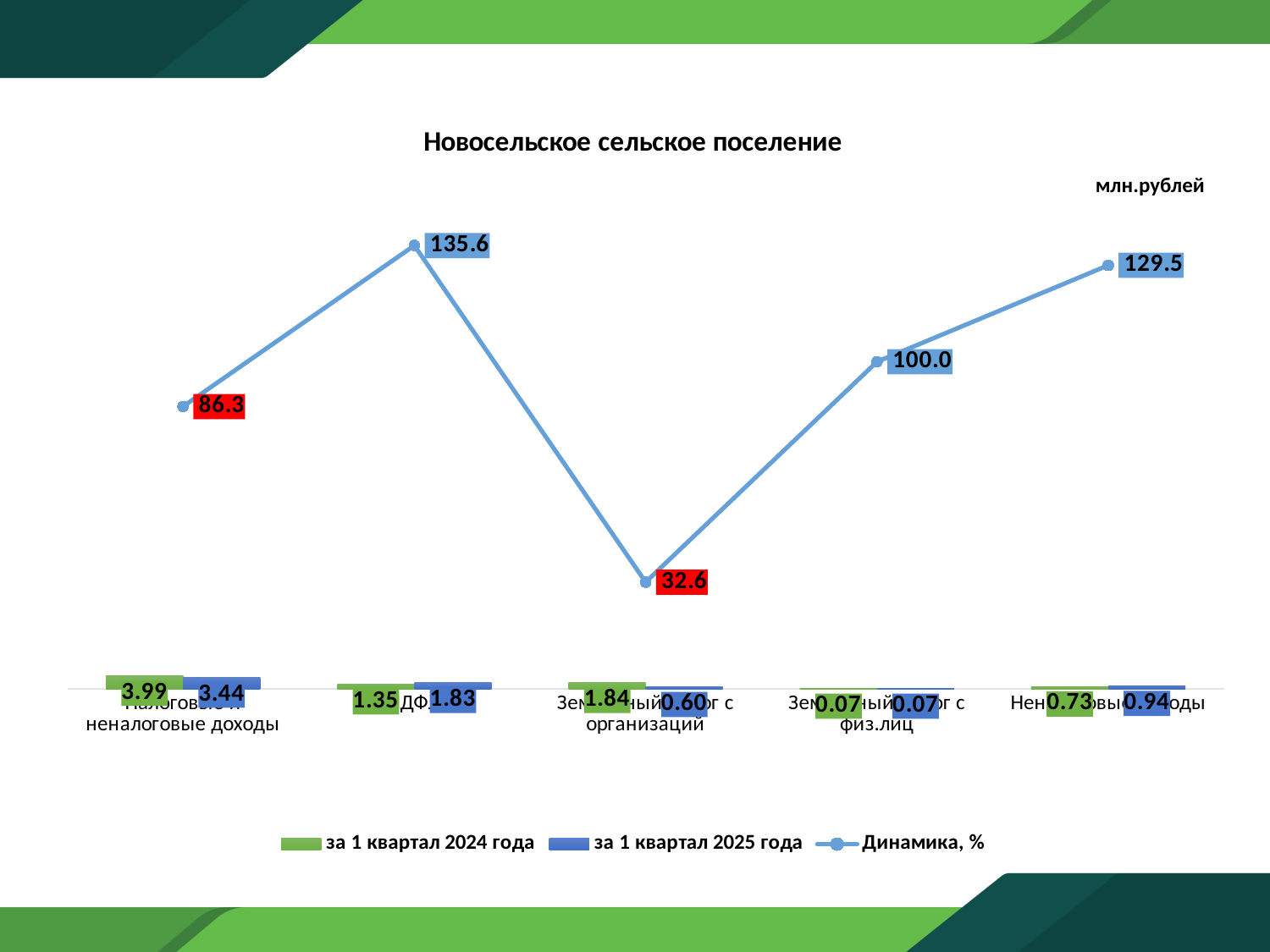
What is the value for 'за 1 квартал 2024 года' for 'Налоговые и неналоговые доходы'? 3.99 Which category has the lowest value of 'Динамика, %'? Земельный налог с организаций What is the value of 'Динамика, %' for НДФЛ? 135.6 What is the value for 'за 1 квартал 2025 года' for 'Земельный налог с организаций'? 0.60 What is the title of the chart? Новосельское сельское поселение How many categories are shown on the x axis? 5 What is the difference between the 'за 1 квартал 2024 года' and 'за 1 квартал 2025 года' values for 'Налоговые и неналоговые доходы'? 0.55 How many series does the legend list? 3 Which category has the highest value of 'Динамика, %'? НДФЛ Which is larger for 'Неналоговые доходы': the value for 'за 1 квартал 2024 года' or for 'за 1 квартал 2025 года'? за 1 квартал 2025 года What unit is indicated in the top right of the chart? млн.рублей What is the value of 'Динамика, %' for 'Земельный налог с физ.лиц'? 100.0